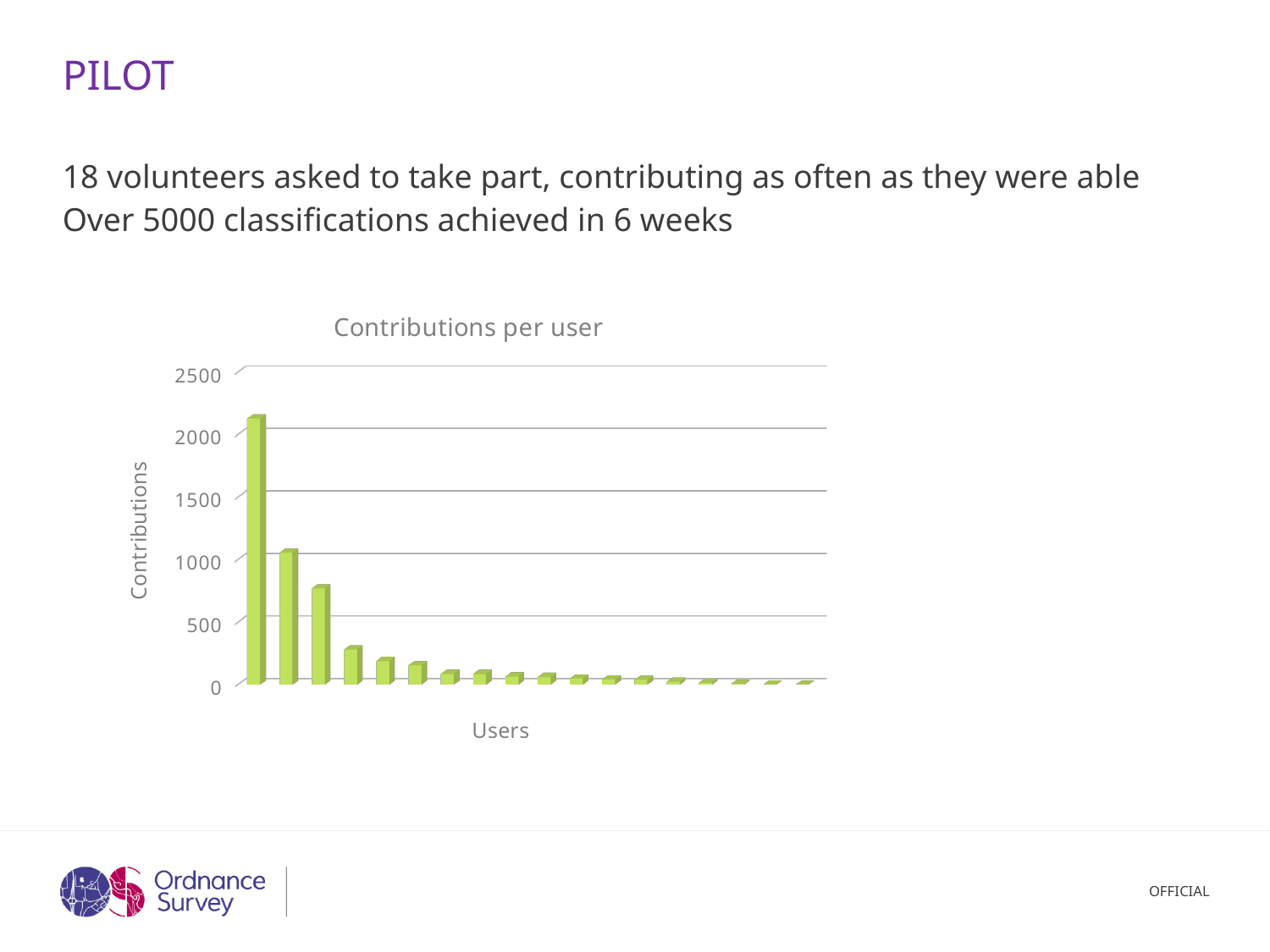
Which is larger, the first bar or the second bar from the left? the first bar Is the value of the leftmost bar greater or less than 2000? greater Is the value of the third bar from the left greater or less than 1000? less What is the label on the vertical axis of the chart? Contributions How many bars (users) are plotted in the chart? 18 Is the value of the third bar from the left greater or less than 500? greater What kind of chart is shown on the slide? bar chart Which bar has the highest number of contributions? the leftmost (first) bar Do the contribution values rise or fall moving from left to right along the x axis? fall What is the title of the chart? Contributions per user